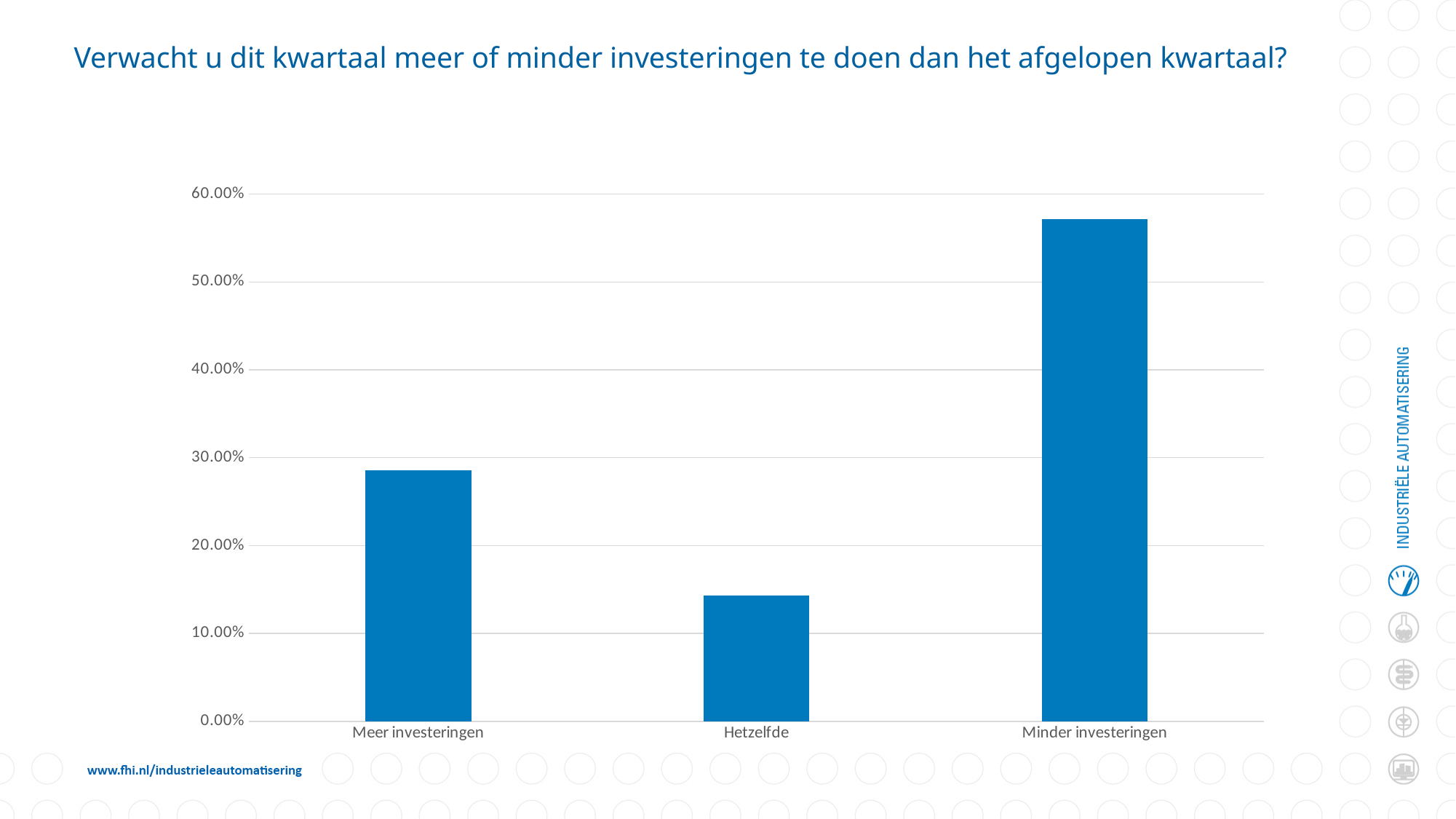
Is the value for Minder investeringen greater or less than 60.00%? less Is the value for Meer investeringen greater or less than 30.00%? less What kind of chart is shown on the slide? bar chart Which category has the highest value in the chart? Minder investeringen Which is larger, the value for Minder investeringen or the value for Meer investeringen? Minder investeringen What is the title of the chart on the slide? Verwacht u dit kwartaal meer of minder investeringen te doen dan het afgelopen kwartaal? How many categories are shown on the x axis of the chart? 3 Which category has the lowest value in the chart? Hetzelfde Is the value for Meer investeringen greater or less than 20.00%? greater Which is larger, the value for Meer investeringen or the value for Hetzelfde? Meer investeringen